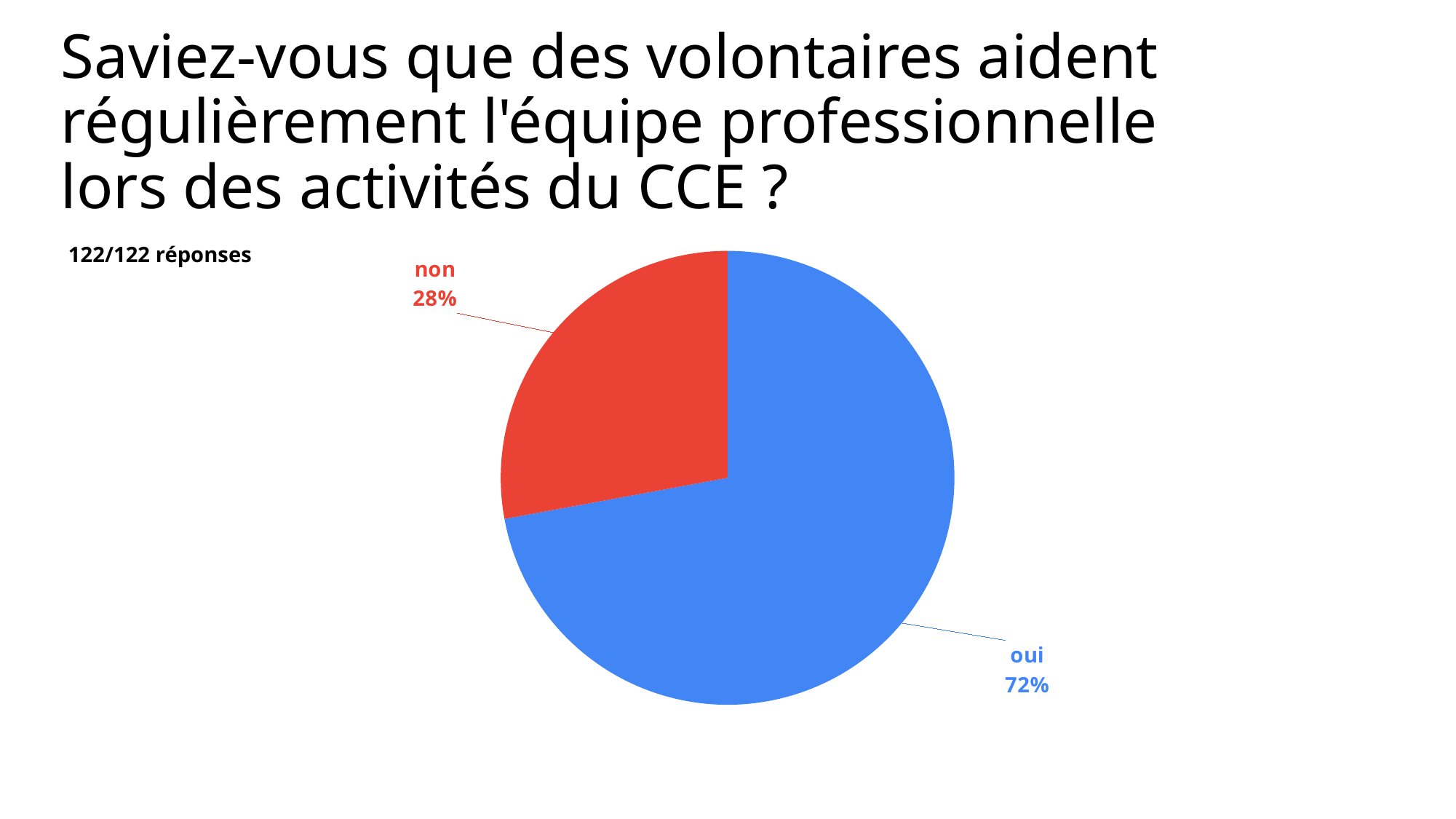
Is the share for "non" greater or less than 50%? less What kind of chart is shown on the slide? pie chart What colour is the "oui" slice? blue What share of the pie does the "non" slice represent? 28% Which is larger, the "oui" slice or the "non" slice? oui Which slice of the pie is the largest? oui What share of the pie does the "oui" slice represent? 72% How many responses does the slide say the chart is based on? 122/122 réponses What is the difference in percentage points between the "oui" and "non" slices? 44 How many slices does the pie chart have? 2 Which slice of the pie is the smallest? non